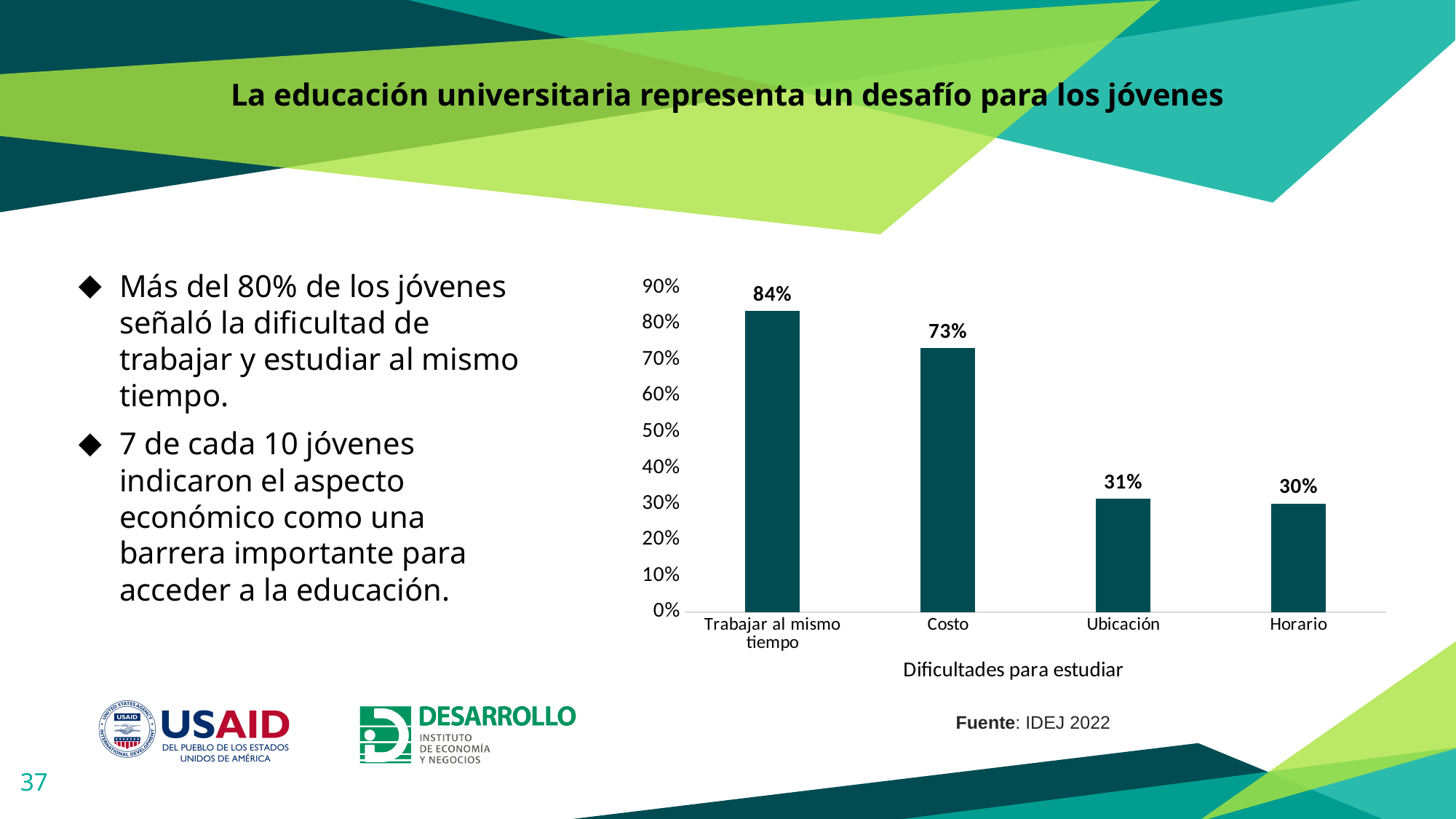
What is the difference between the values for Ubicación and Horario? 1% Which category has the highest value? Trabajar al mismo tiempo What is the value for Trabajar al mismo tiempo? 84% How many categories are shown on the x axis? 4 What is the x-axis title of the chart? Dificultades para estudiar Which is larger, the value for Costo or the value for Ubicación? Costo Is the value for Ubicación greater or less than 40%? less What is the value for Horario? 30% What is the value for Costo? 73% What kind of chart is shown on the slide? bar chart Which category has the lowest value? Horario What is the difference between the values for Trabajar al mismo tiempo and Costo? 11%